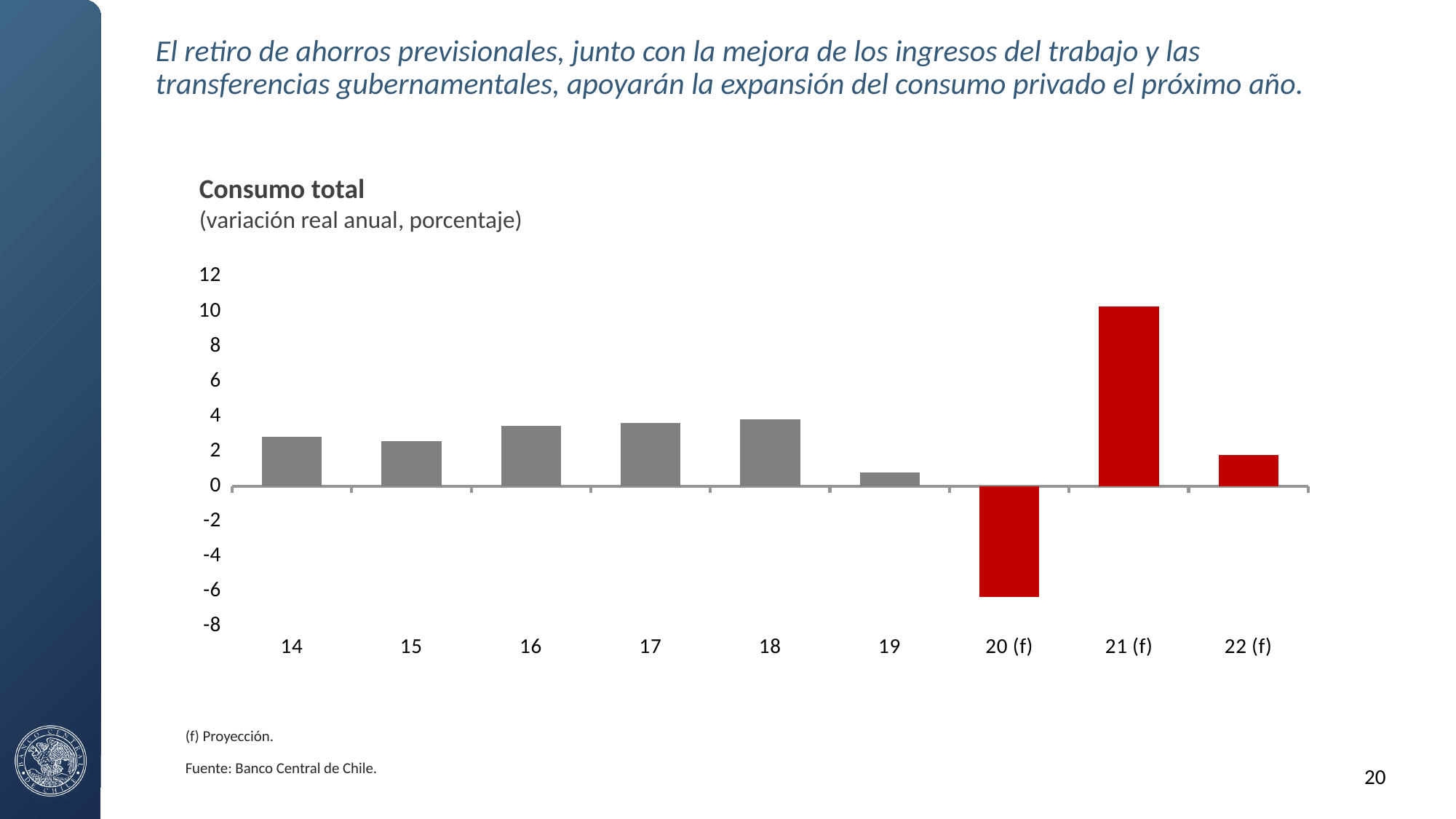
Is the value for 21 (f) greater or less than 8? greater Is the value for 20 (f) greater or less than -4? less Which year has the highest value for Consumo total? 21 (f) Which year has the lowest value for Consumo total? 20 (f) Do the values rise or fall from 18 to 20 (f)? fall Which is larger, the value for 21 (f) or the value for 22 (f)? 21 (f) What is the title of the chart? Consumo total Is the value for 19 greater or less than 2? less Which is larger, the value for 18 or the value for 19? 18 What kind of chart is shown on the slide? bar chart How many years (categories) are shown on the x axis of the chart? 9